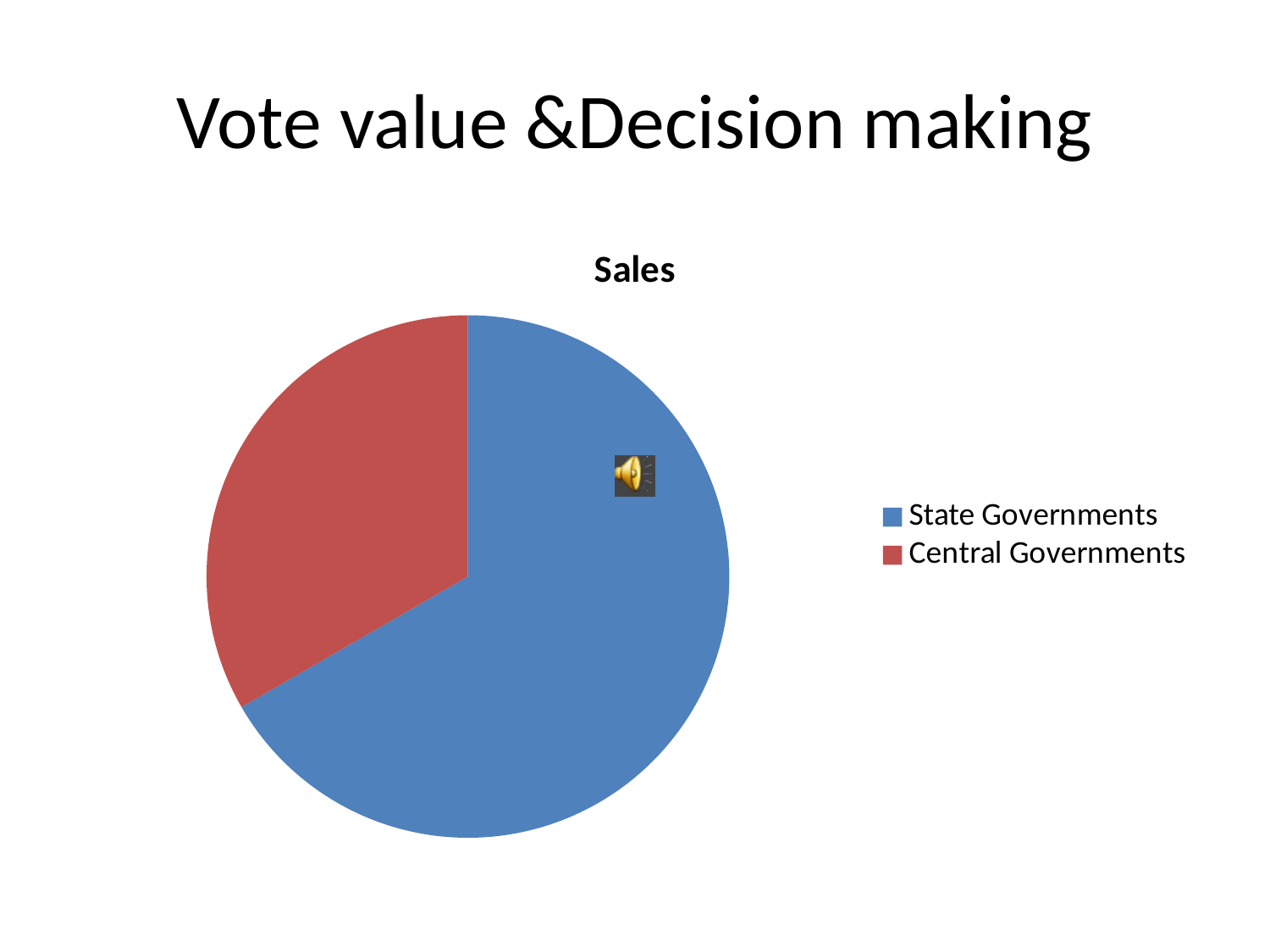
Which slice is larger, State Governments or Central Governments? State Governments How many entries does the legend list? 2 Which category has the largest slice of the pie? State Governments How many slices does the pie chart have? 2 Which category has the smallest slice of the pie? Central Governments What is the title of the chart? Sales What colour is the State Governments slice? blue What kind of chart is shown on the slide? pie chart